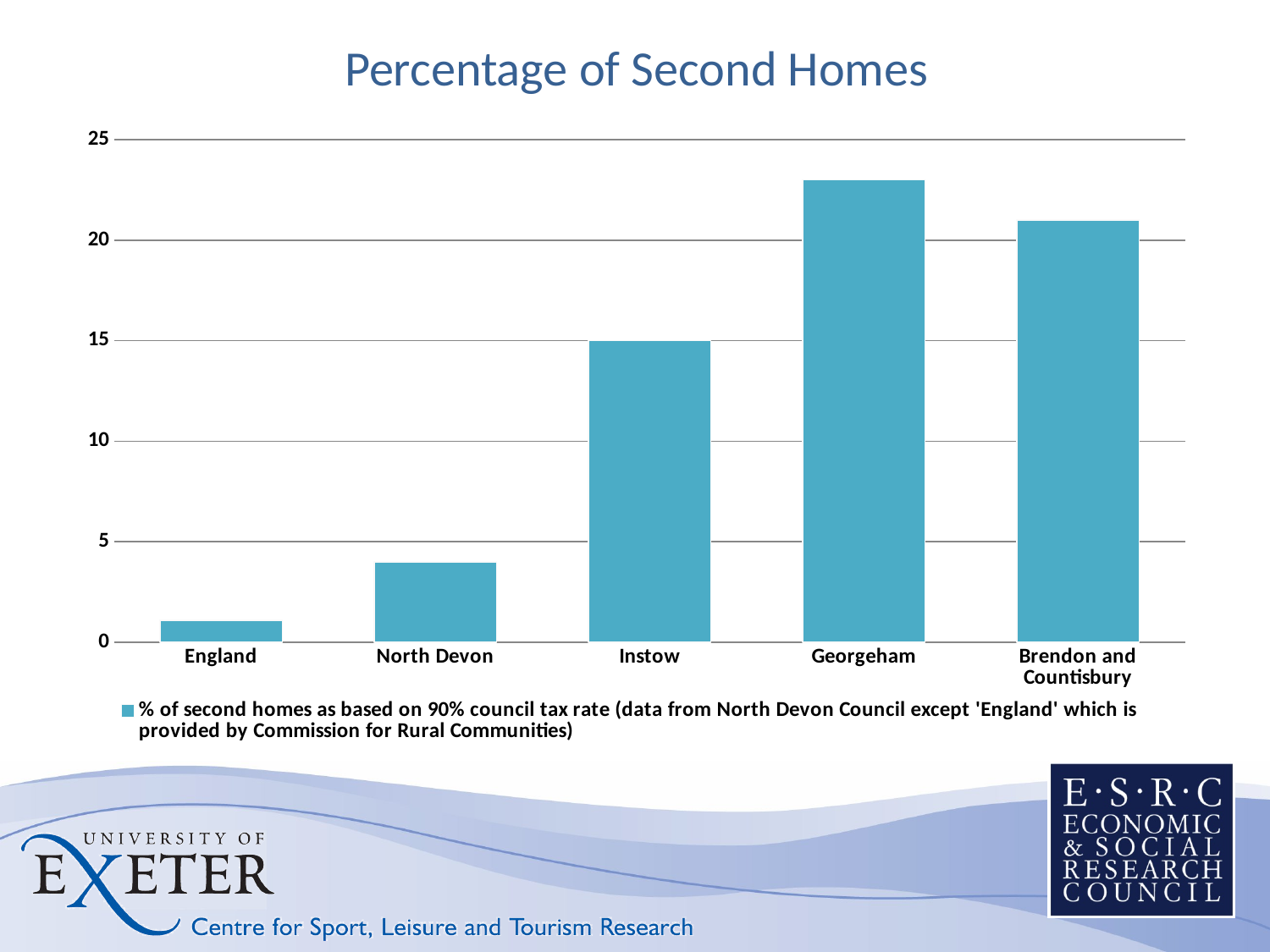
What kind of chart is shown on the slide? bar chart Is the value for Brendon and Countisbury greater or less than 20? greater Which has a higher value, North Devon or Instow? Instow How many series does the legend list? 1 Is the value for Georgeham greater or less than 20? greater Is the value for North Devon greater or less than 5? less What is the title of the chart? Percentage of Second Homes Which has a higher value, Georgeham or Brendon and Countisbury? Georgeham Which category has the lowest percentage of second homes? England How many categories are shown on the x axis of the chart? 5 What is the value for Instow? 15 Which category has the highest percentage of second homes? Georgeham